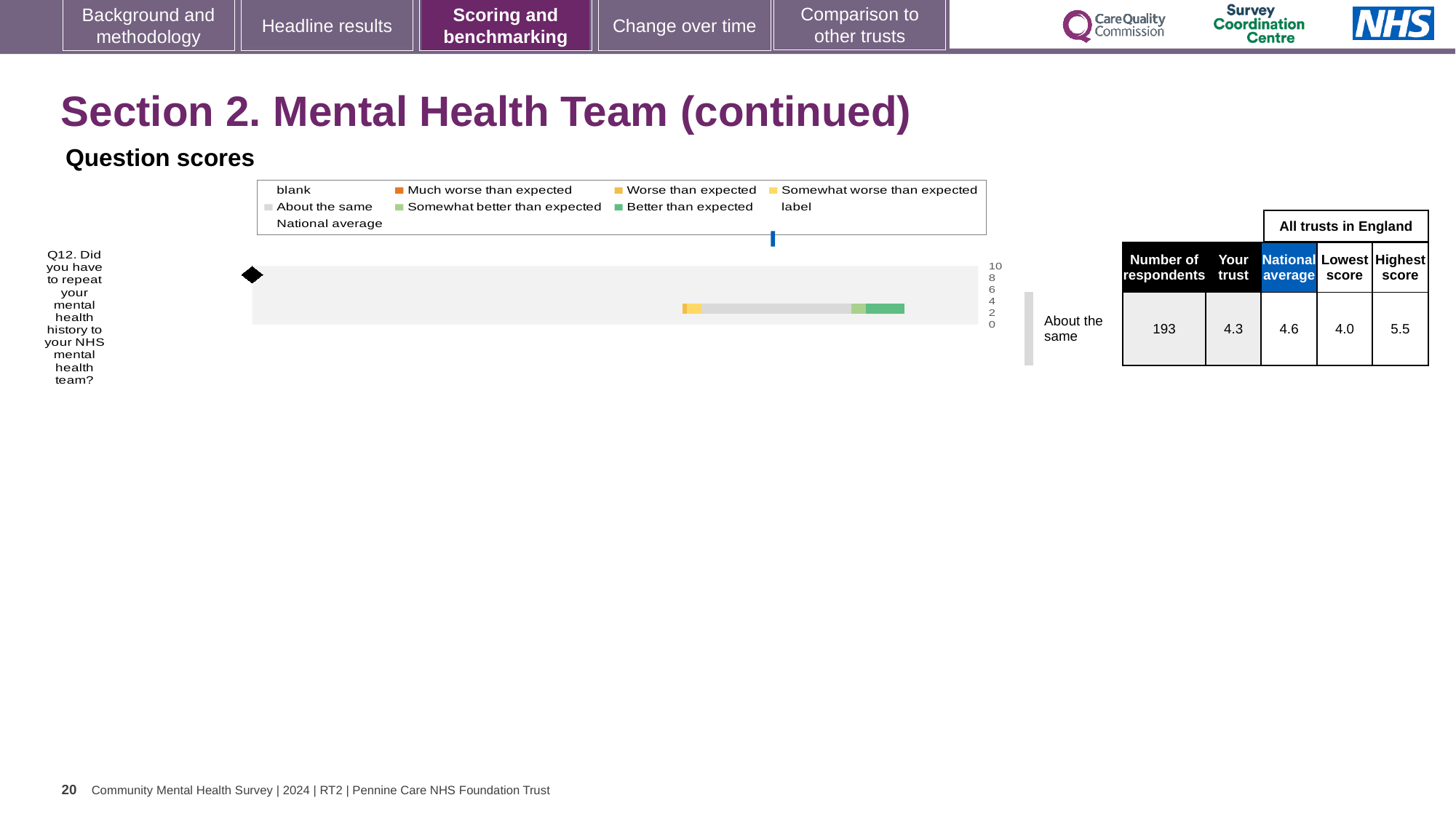
What is the highest score among all trusts in England for Q12? 5.5 What is the difference between the highest and lowest scores among all trusts in England for Q12? 1.5 What is the lowest score among all trusts in England for Q12? 4.0 What is the difference between the national average and the 'Your trust' score for Q12? 0.3 Which is larger for Q12, the 'Your trust' score or the national average? National average What kind of chart is shown on the slide? bar chart How is the trust's result for Q12 categorised relative to expectations? About the same What is the 'Your trust' score for Q12? 4.3 Which question is plotted in the chart? Q12. Did you have to repeat your mental health history to your NHS mental health team? How many respondents answered Q12? 193 How many questions are plotted in the chart? 1 What is the national average score for Q12? 4.6